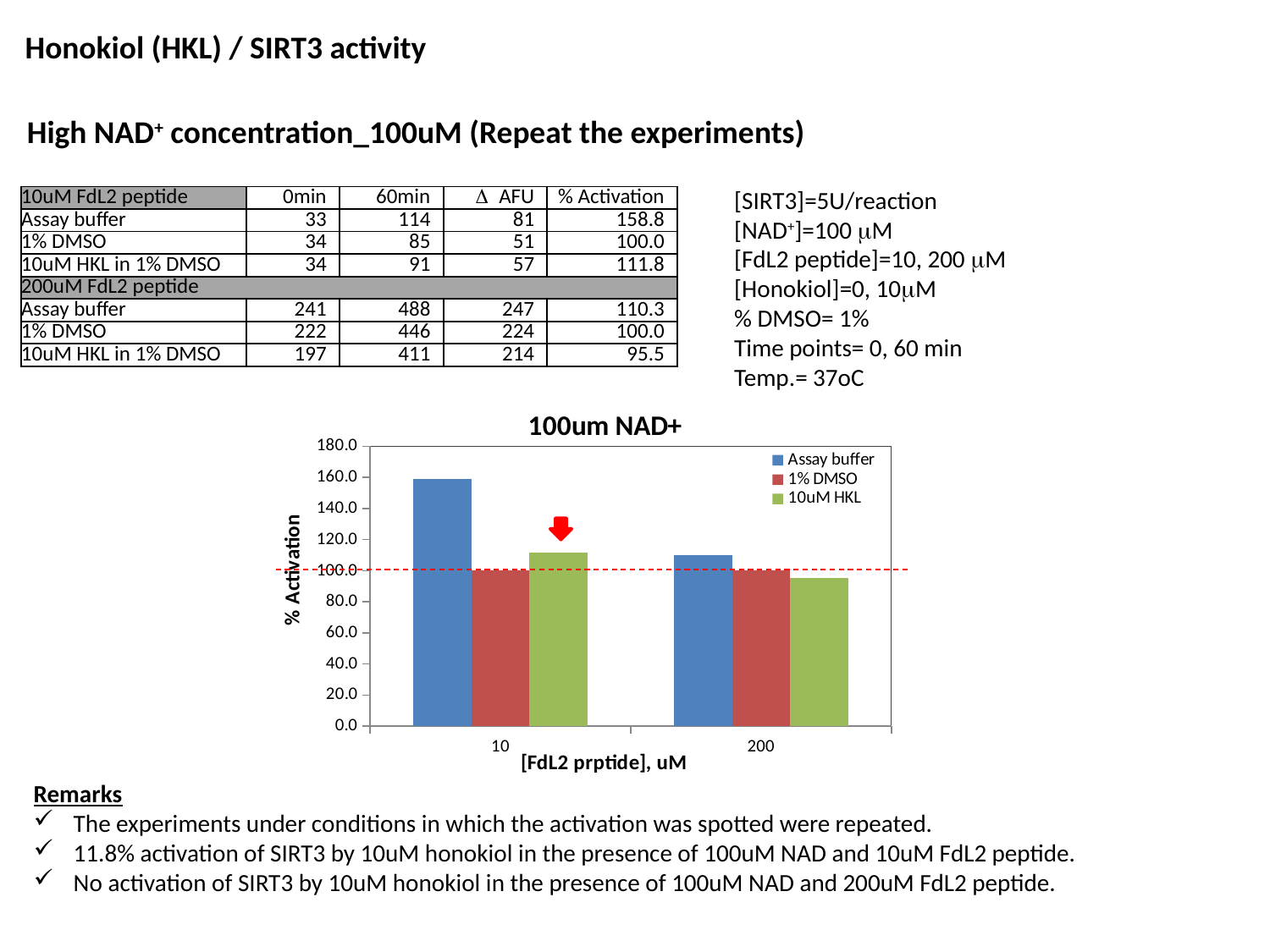
Is the 10uM HKL value at 10 uM FdL2 peptide greater or less than 100? greater Which series has the highest bar in the chart? Assay buffer Is the Assay buffer value at 200 uM FdL2 peptide greater or less than 120? less What is the title of the chart? 100um NAD+ What is the label of the y axis of the chart? % Activation What kind of chart is shown on the slide? bar chart How many series does the chart legend list? 3 How many FdL2 peptide concentration categories are shown on the x axis of the chart? 2 Which is larger: the 10uM HKL value at 10 uM FdL2 peptide or at 200 uM FdL2 peptide? 10 uM FdL2 peptide Is the 10uM HKL value at 200 uM FdL2 peptide greater or less than 100? less Which is larger: the Assay buffer value at 10 uM FdL2 peptide or at 200 uM FdL2 peptide? 10 uM FdL2 peptide